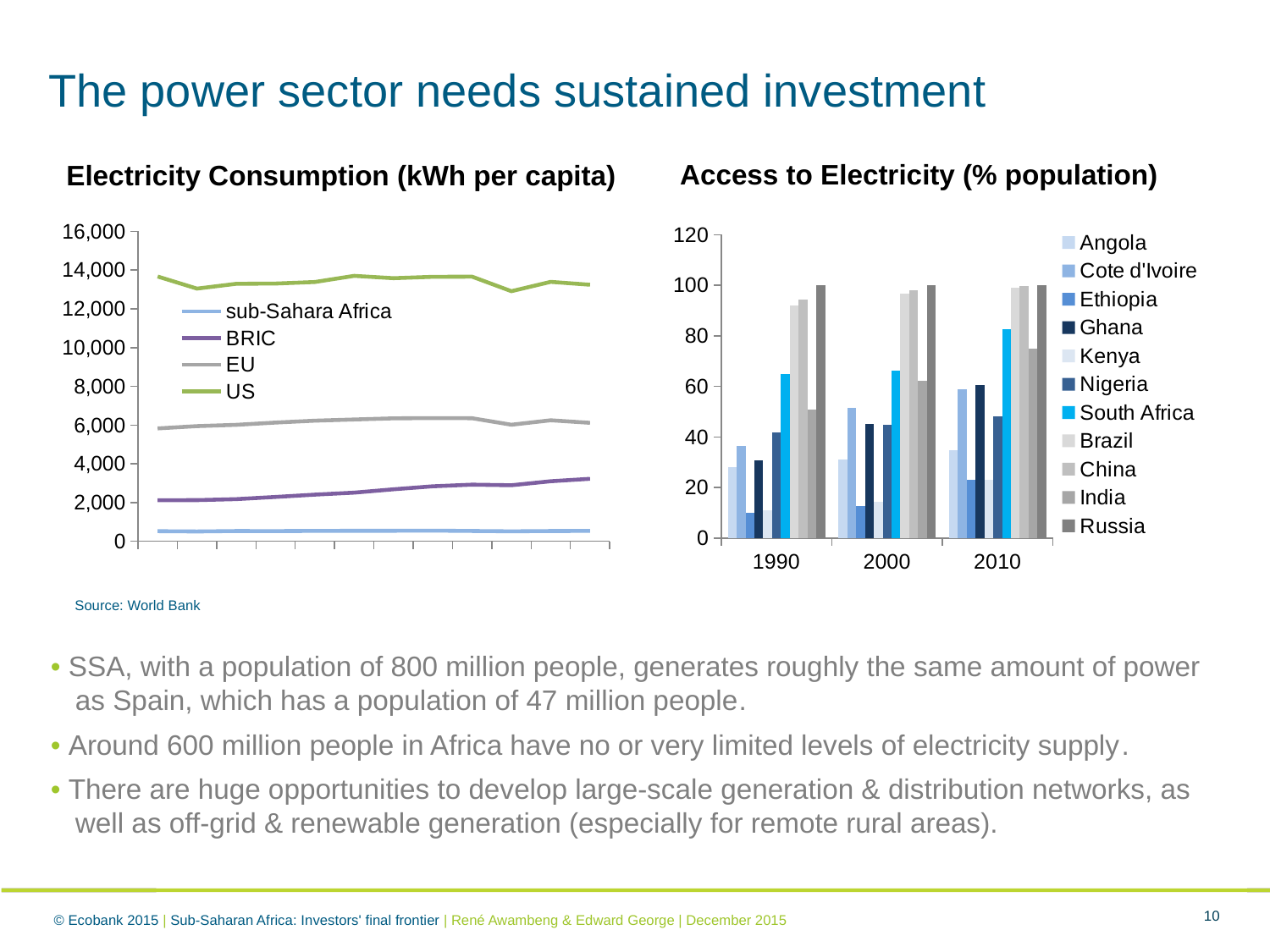
What kind of chart is the 'Electricity Consumption (kWh per capita)' chart on the left? line chart How many year categories are shown on the x axis of the 'Access to Electricity (% population)' chart? 3 In the 'Electricity Consumption (kWh per capita)' chart, does the BRIC line rise or fall along the x axis? rise How many series does the legend of the 'Electricity Consumption (kWh per capita)' chart list? 4 What kind of chart is the 'Access to Electricity (% population)' chart on the right? bar chart In the 'Electricity Consumption (kWh per capita)' chart, which series has the lowest values? sub-Sahara Africa In the 'Electricity Consumption (kWh per capita)' chart, is the EU line greater or less than 8,000? less How many series does the legend of the 'Access to Electricity (% population)' chart list? 11 In the 'Access to Electricity (% population)' chart, which country has the highest value in 1990? Russia In the 'Electricity Consumption (kWh per capita)' chart, which series has the highest values? US In the 'Access to Electricity (% population)' chart, is the value for South Africa in 2010 greater or less than 60? greater In the 'Access to Electricity (% population)' chart, which is larger in 2010: South Africa or India? South Africa